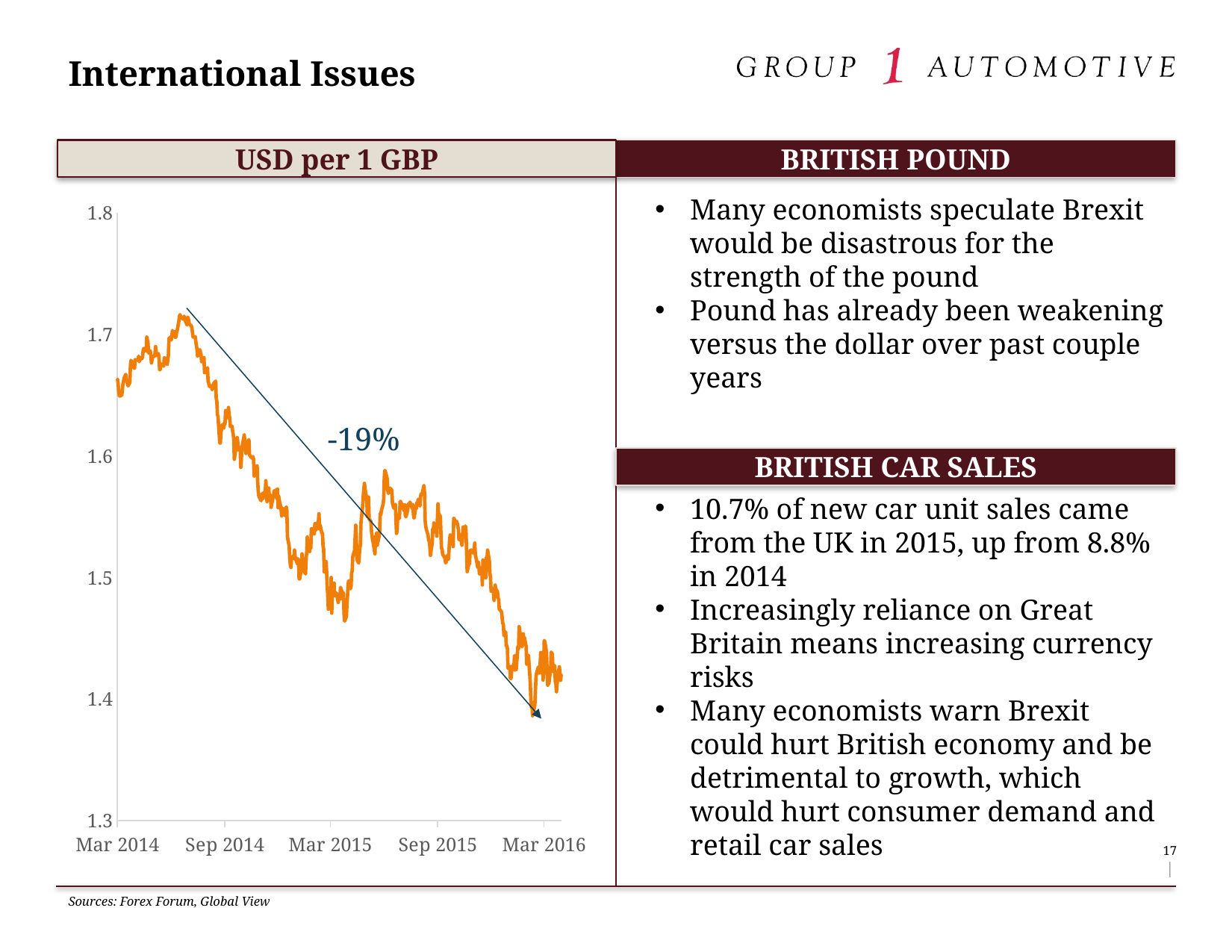
Is the value for Mar 2014 on the USD per 1 GBP chart greater or less than 1.6? greater What is the lowest value shown on the y axis of the USD per 1 GBP chart? 1.3 Is the highest point on the USD per 1 GBP chart greater or less than 1.7? greater Is the value for Mar 2016 on the USD per 1 GBP chart greater or less than 1.5? less What percentage change is annotated on the USD per 1 GBP chart? -19% Overall, does the USD per 1 GBP line rise or fall from Mar 2014 to Mar 2016? Fall On the USD per 1 GBP chart, which is larger: the value at Mar 2014 or the value at Mar 2016? Mar 2014 How many date labels are shown on the x axis of the USD per 1 GBP chart? 5 What is the title of the chart on the left of the slide? USD per 1 GBP On the USD per 1 GBP chart, which is larger: the value at Sep 2014 or the value at Sep 2015? Sep 2014 What kind of chart is shown under the heading "USD per 1 GBP"? Line chart